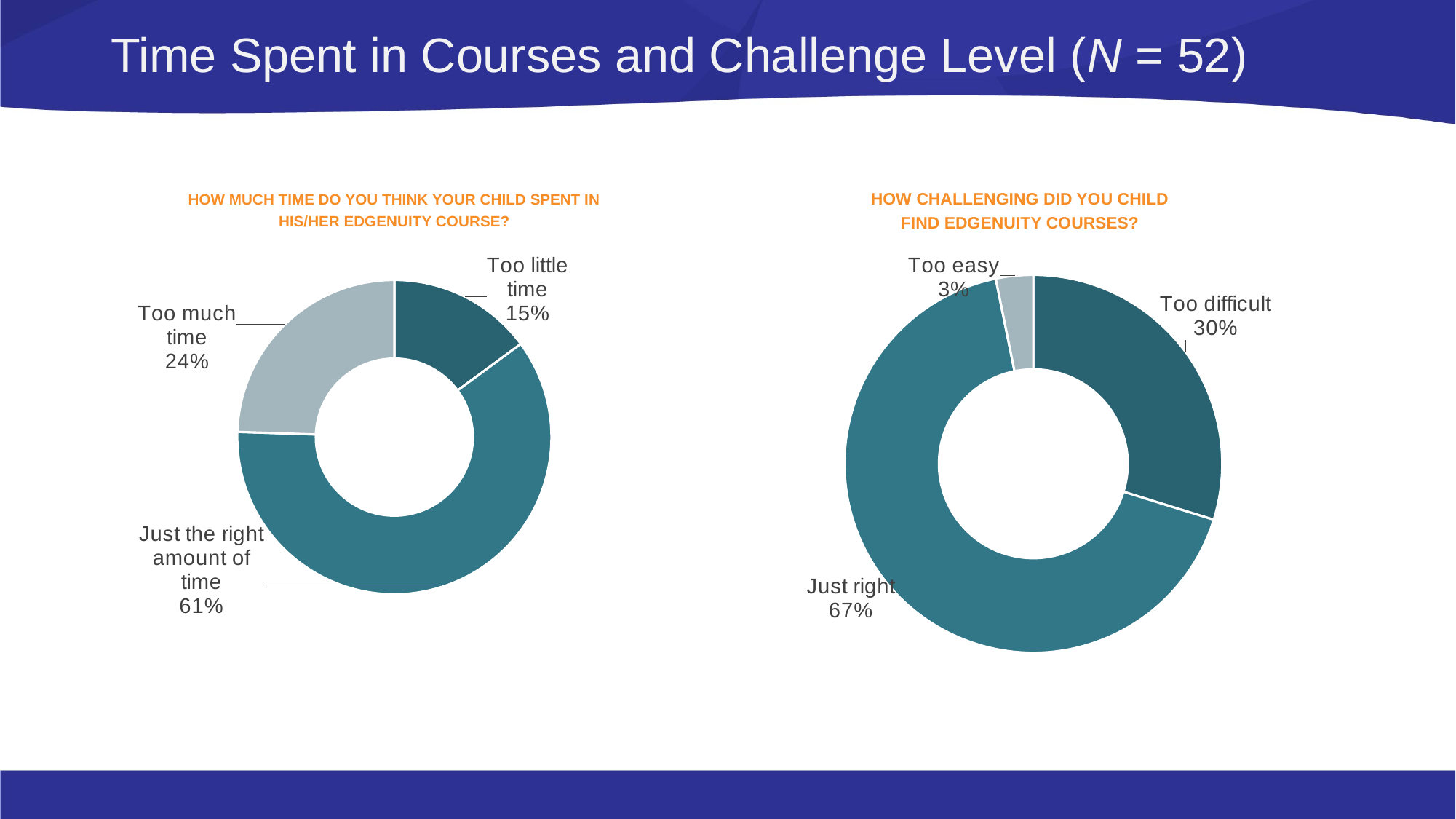
In the left chart (how much time your child spent in the Edgenuity course), which category has the smallest share? Too little time In the left chart (how much time your child spent in the Edgenuity course), what is the difference in percentage points between 'Too much time' and 'Too little time'? 9 percentage points In the left chart (how much time your child spent in the Edgenuity course), what share of respondents chose 'Too little time'? 15% What type of chart is used for both charts on the slide? Doughnut (pie) chart In the right chart (how challenging did your child find Edgenuity courses), which category has the largest share? Just right In the left chart (how much time your child spent in the Edgenuity course), how many categories are shown? 3 In the right chart (how challenging did your child find Edgenuity courses), what is the difference in percentage points between 'Just right' and 'Too difficult'? 37 percentage points In the right chart (how challenging did your child find Edgenuity courses), which is larger: 'Too difficult' or 'Too easy'? Too difficult In the right chart (how challenging did your child find Edgenuity courses), what share of respondents chose 'Too difficult'? 30% In the left chart (how much time your child spent in the Edgenuity course), what share of respondents chose 'Just the right amount of time'? 61% In the right chart (how challenging did your child find Edgenuity courses), what share of respondents chose 'Too easy'? 3% In the left chart (how much time your child spent in the Edgenuity course), what share of respondents chose 'Too much time'? 24%